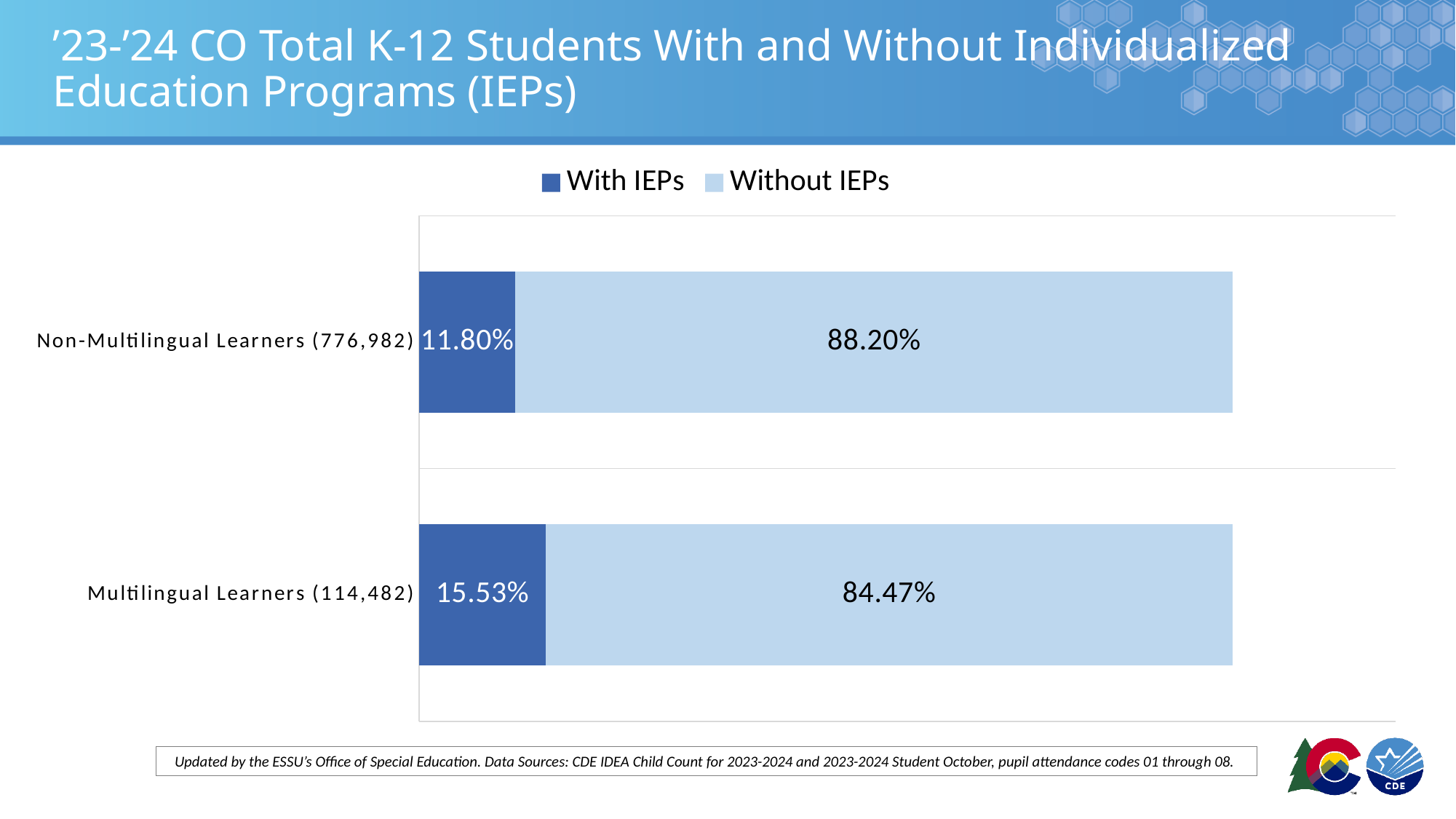
Which category has the higher percentage of students with IEPs? Multilingual Learners What is the total student count shown in the label for Multilingual Learners? 114,482 What is the difference in percentage points between the With IEPs share for Multilingual Learners and Non-Multilingual Learners? 3.73 How many series does the legend list? 2 What percentage of Multilingual Learners have IEPs? 15.53% Is the Without IEPs share larger for Non-Multilingual Learners or Multilingual Learners? Non-Multilingual Learners What percentage of Multilingual Learners are without IEPs? 84.47% What percentage of Non-Multilingual Learners have IEPs? 11.80% What percentage of Non-Multilingual Learners are without IEPs? 88.20% What kind of chart is shown on the slide? Stacked bar chart Which category has the lower percentage of students without IEPs? Multilingual Learners How many categories are shown on the chart? 2